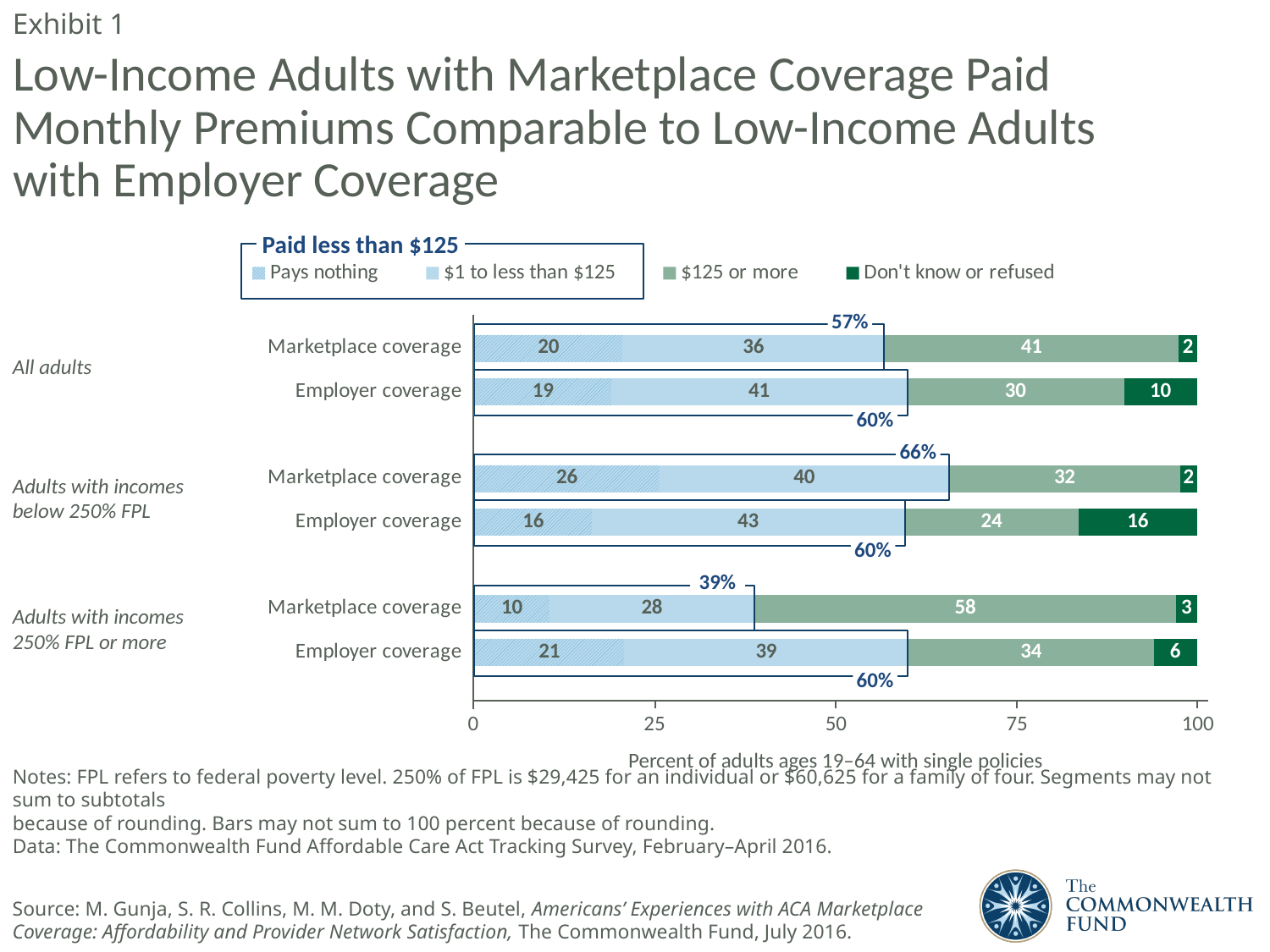
What kind of chart is shown on the slide? Stacked bar chart How many bars are plotted in the chart? 6 Among adults with incomes 250% FPL or more, what is the 'Pays nothing' value for Marketplace coverage? 10 Among adults with incomes below 250% FPL, what is the 'Don't know or refused' value for Employer coverage? 16 What percentage of all adults with Marketplace coverage paid $125 or more? 41 Which two legend entries are grouped under the heading 'Paid less than $125'? Pays nothing and $1 to less than $125 Among all adults, what is the difference between the '$1 to less than $125' values for Employer coverage and Marketplace coverage? 5 How many series does the legend list? 4 Which bar has the highest '$125 or more' value? Marketplace coverage, adults with incomes 250% FPL or more Among all adults, is the 'Don't know or refused' value larger for Marketplace coverage or Employer coverage? Employer coverage What subtotal is shown for 'Paid less than $125' for Marketplace coverage among adults with incomes below 250% FPL? 66% Which bar has the lowest 'Pays nothing' value? Marketplace coverage, adults with incomes 250% FPL or more